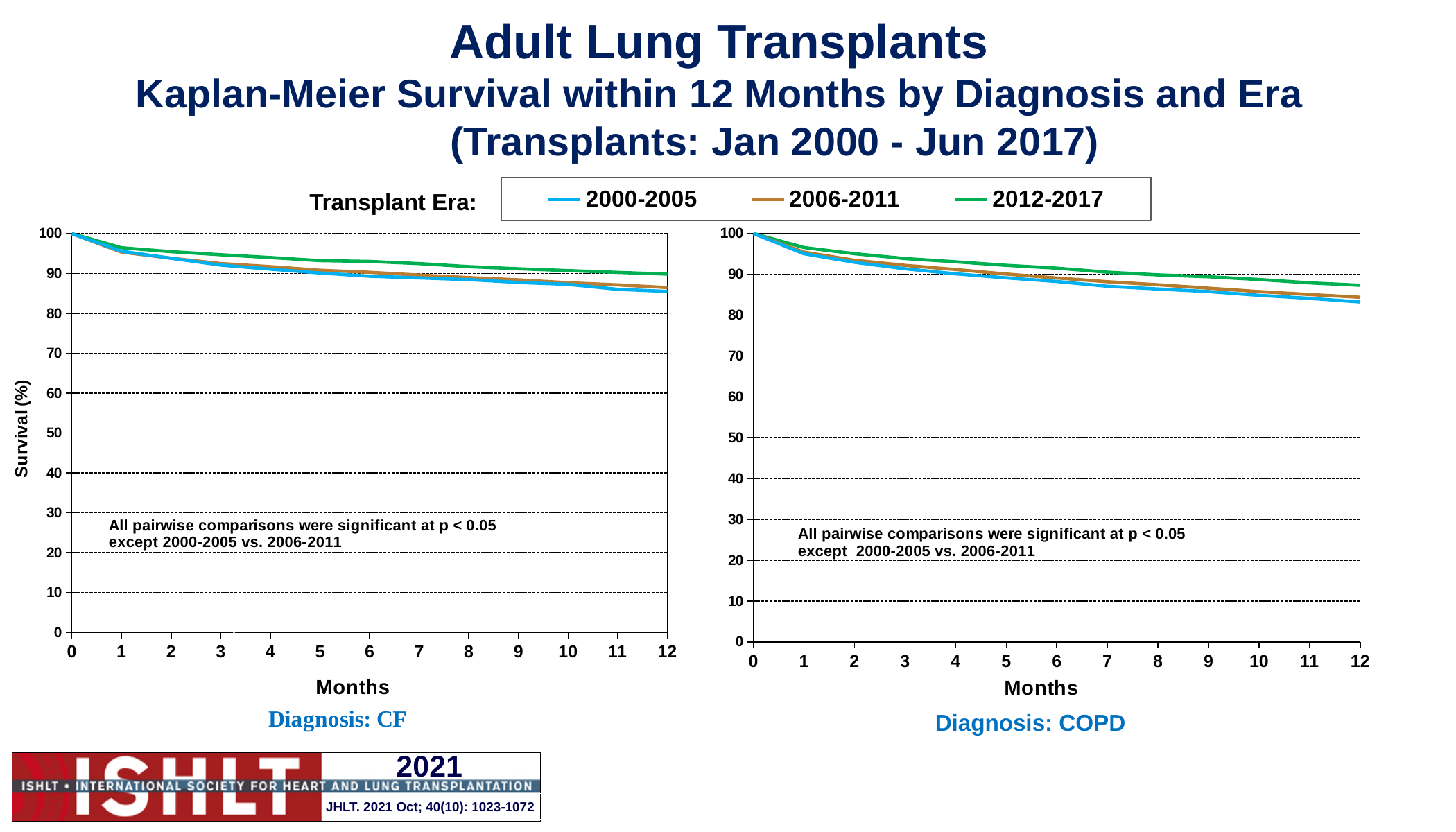
How many transplant eras does the legend list? 3 In the Diagnosis: COPD chart, does survival rise or fall from month 0 to month 12? fall In the Diagnosis: CF chart, at 6 months, which is higher: the 2012-2017 era or the 2000-2005 era? 2012-2017 In the Diagnosis: COPD chart, at 12 months, which is higher: the 2012-2017 era or the 2000-2005 era? 2012-2017 In the Diagnosis: CF chart, is the survival for the 2000-2005 era at 12 months greater or less than 90? less Which colour represents the 2006-2011 era in the legend? brown In the Diagnosis: COPD chart, which era has the highest survival at 12 months? 2012-2017 In the Diagnosis: CF chart, does survival rise or fall as months increase? fall In the Diagnosis: CF chart, which era has the highest survival at 12 months? 2012-2017 What type of chart is the Diagnosis: CF chart? line chart In the Diagnosis: CF chart, what is the survival (%) for the 2012-2017 era at month 0? 100 In the Diagnosis: COPD chart, is the survival for the 2000-2005 era at 12 months greater or less than 80? greater